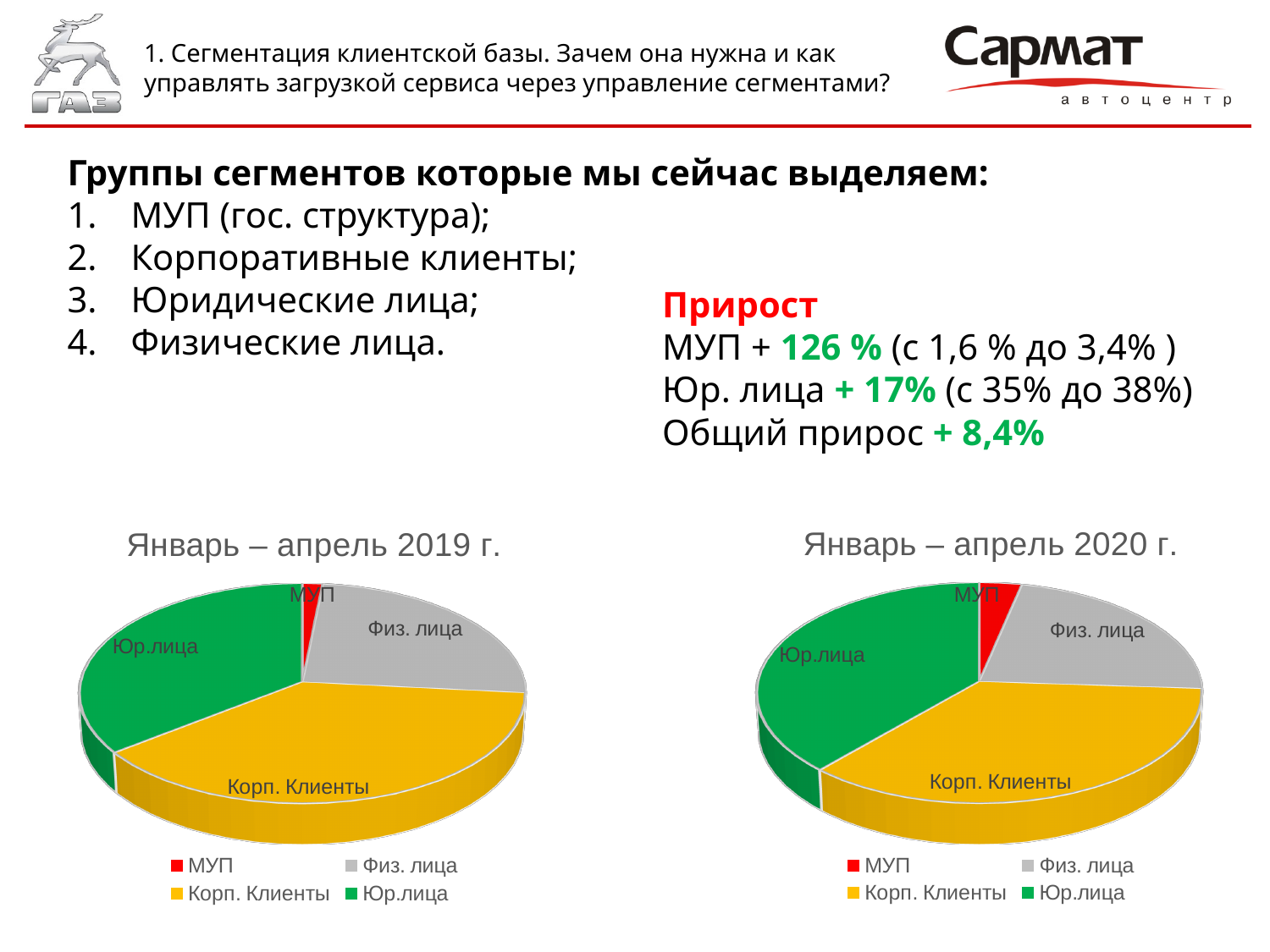
In the "Январь – апрель 2019 г." chart, what colour is the МУП slice? red What kind of chart is shown under the title "Январь – апрель 2019 г."? pie chart In the "Январь – апрель 2020 г." chart, which category has the largest slice? Юр.лица How many entries does the legend of the "Январь – апрель 2019 г." chart list? 4 What is the title of the pie chart on the right side of the slide? Январь – апрель 2020 г. In the "Январь – апрель 2020 г." chart, which slice is larger: Физ. лица or МУП? Физ. лица In the "Январь – апрель 2020 г." chart, which category has the smallest slice? МУП In the "Январь – апрель 2019 г." chart, which category has the smallest slice? МУП In the "Январь – апрель 2019 г." chart, which slice is larger: Юр.лица or Физ. лица? Юр.лица How many slices does the "Январь – апрель 2020 г." pie chart have? 4 In the "Январь – апрель 2019 г." chart, which category has the largest slice? Корп. Клиенты